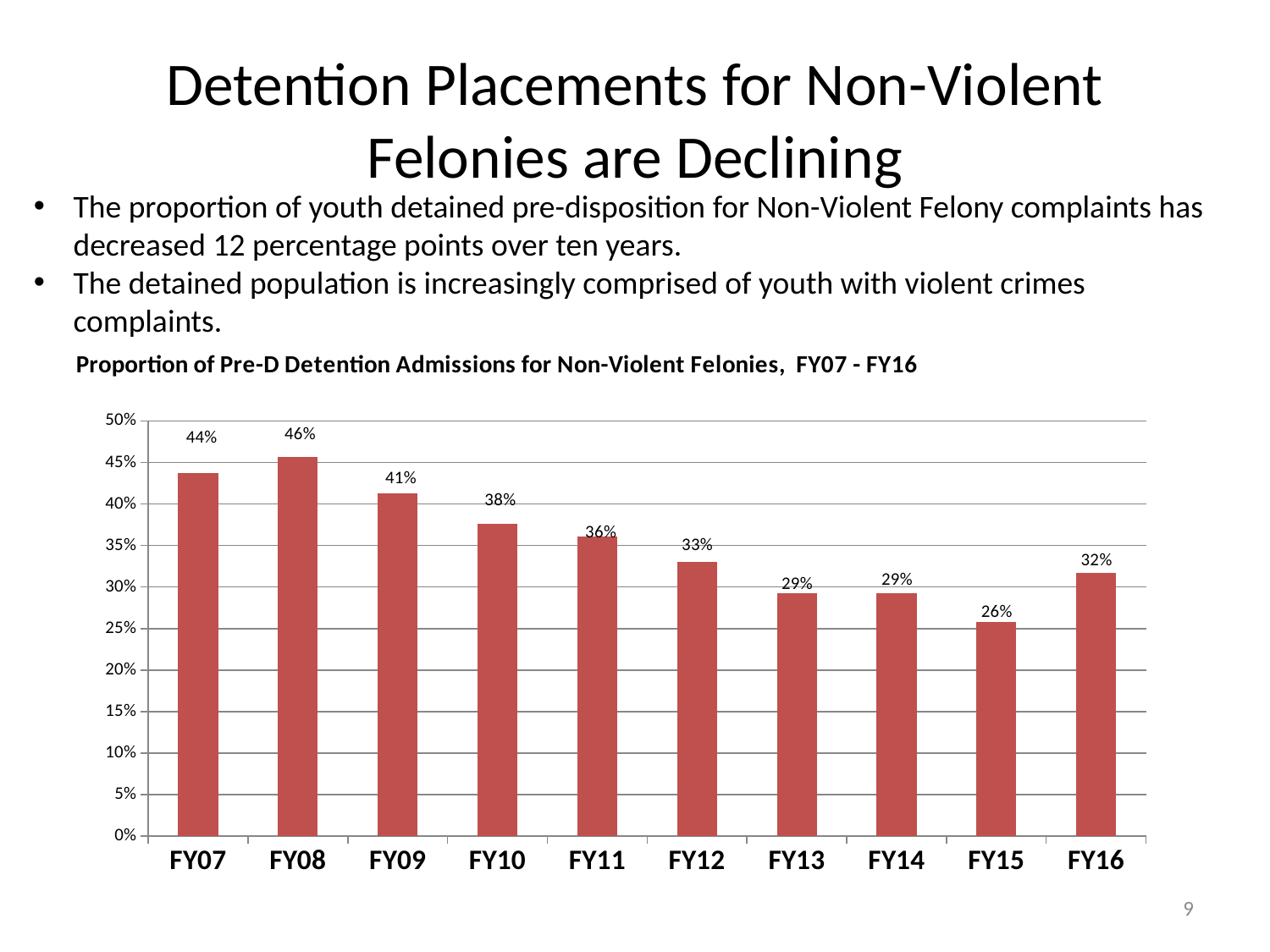
What is the value for FY16? 32% What kind of chart is shown on the slide? Bar chart Which fiscal year has the lowest proportion? FY15 What is the difference between the values for FY08 and FY15? 20 percentage points How many fiscal years are shown on the x axis? 10 What is the title of the chart? Proportion of Pre-D Detention Admissions for Non-Violent Felonies, FY07 - FY16 Which is larger, the value for FY09 or the value for FY12? FY09 Which fiscal year has the highest proportion? FY08 What is the value for FY07? 44% Do the values generally rise or fall from FY07 to FY15? Fall What is the value for FY15? 26% Is the value for FY10 greater or less than 35%? greater